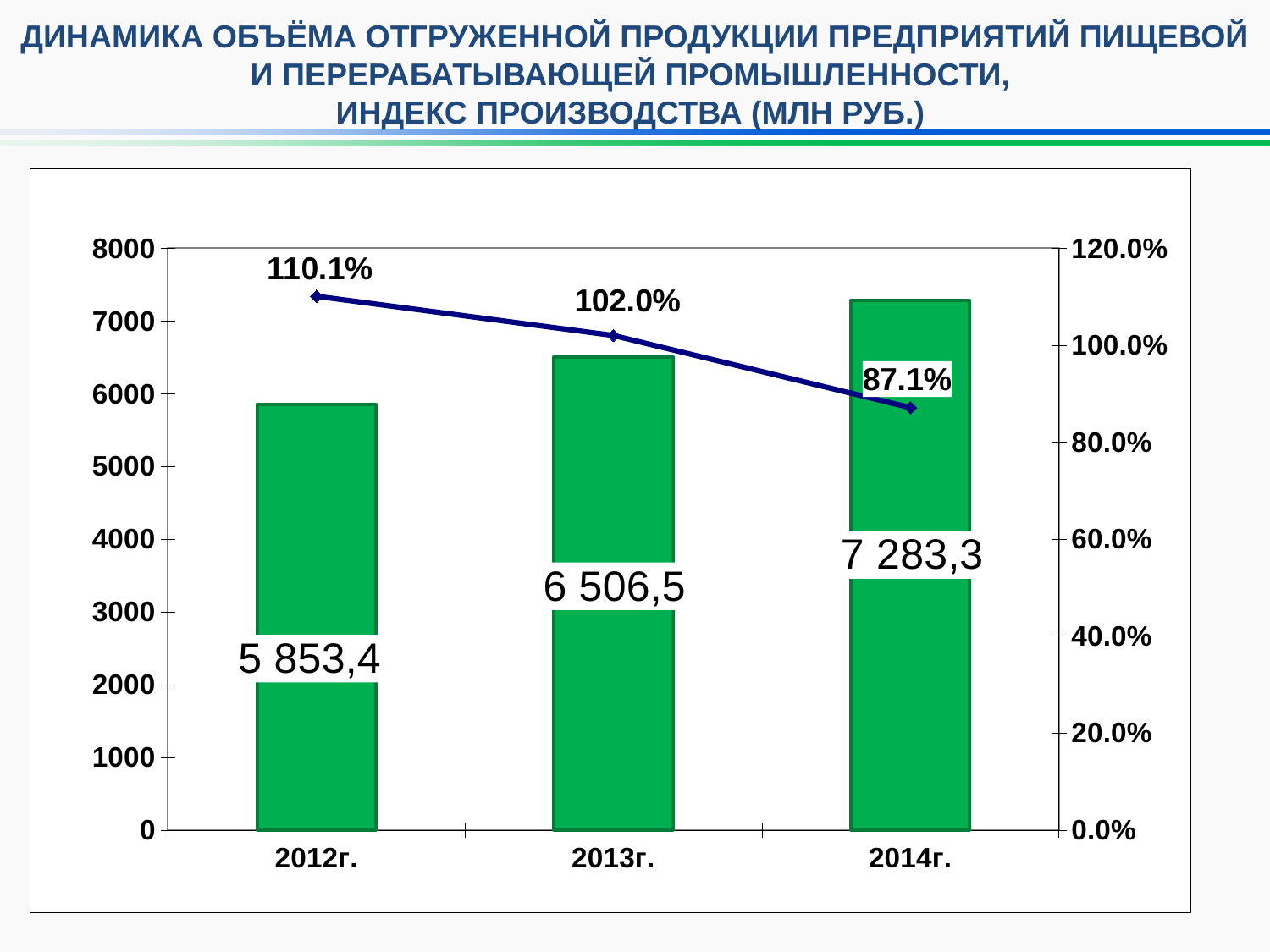
Which is larger, the bar value for 2013г. or for 2014г.? 2014г. Do the bar values rise or fall from 2012г. to 2014г.? rise Which year has the lowest production index on the line? 2014г. What production index value is shown on the line for 2013г.? 102.0% What production index value is shown on the line for 2014г.? 87.1% Which year has the highest bar value? 2014г. What is the difference between the bar values for 2013г. and 2012г.? 653,1 Do the production index values on the line rise or fall from 2012г. to 2014г.? fall What is the value of the bar for 2014г.? 7 283,3 How many years are shown on the x axis? 3 What is the value of the bar for 2012г.? 5 853,4 By how many percentage points does the production index for 2012г. exceed that for 2014г.? 23.0